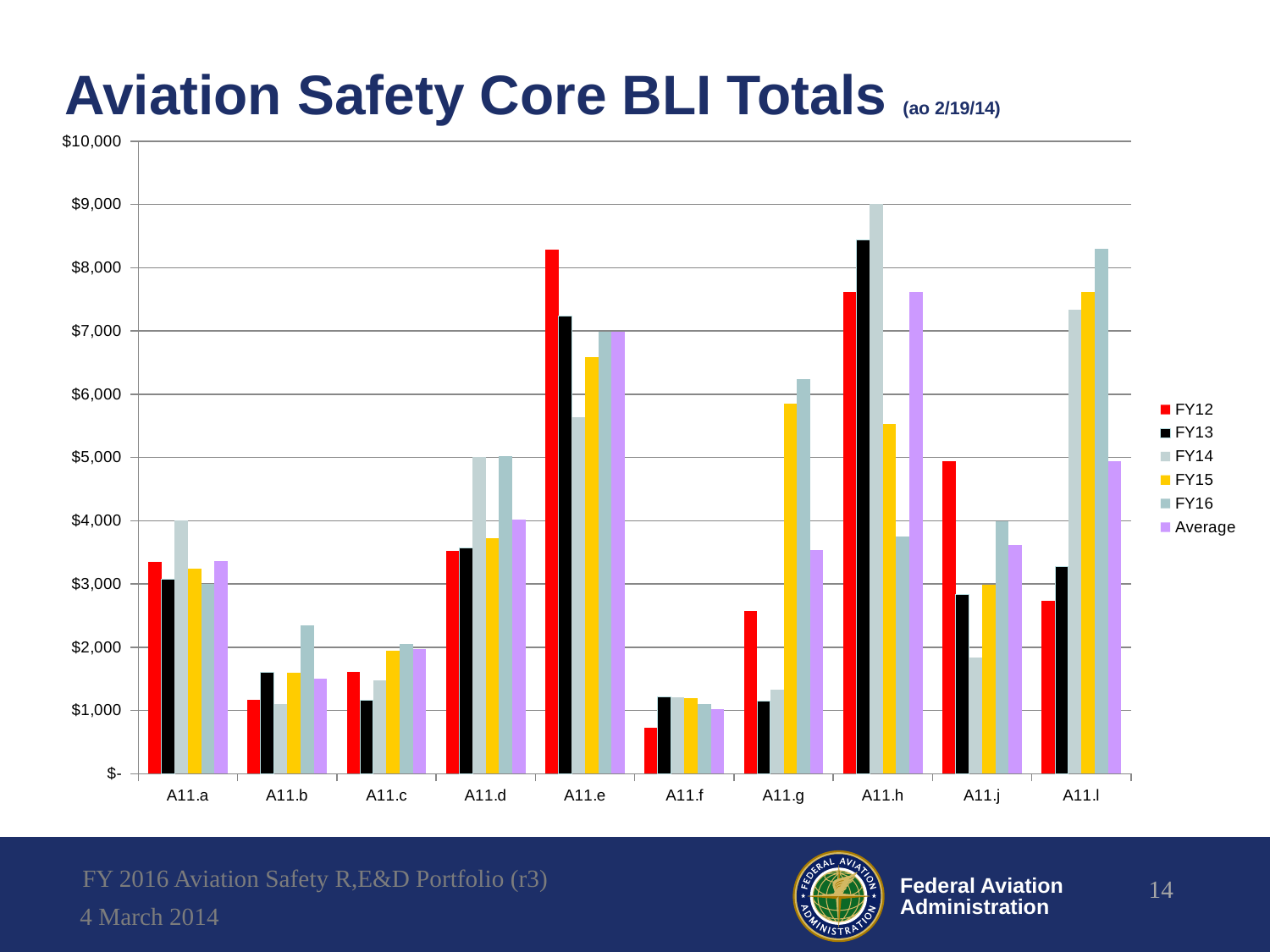
Which category has the lowest FY12 value? A11.f How many series does the legend list? 6 Is the FY16 value for A11.l greater or less than $8,000? greater Is the FY16 value for A11.b greater or less than $2,000? greater Is the FY14 value for A11.h greater or less than $8,000? greater For A11.g, which is larger: the FY12 value or the FY15 value? FY15 What kind of chart is shown on the slide? bar chart What is the title of the chart? Aviation Safety Core BLI Totals Which category has the highest FY12 value? A11.e How many categories are shown along the x axis? 10 Which category has the highest FY14 value? A11.h